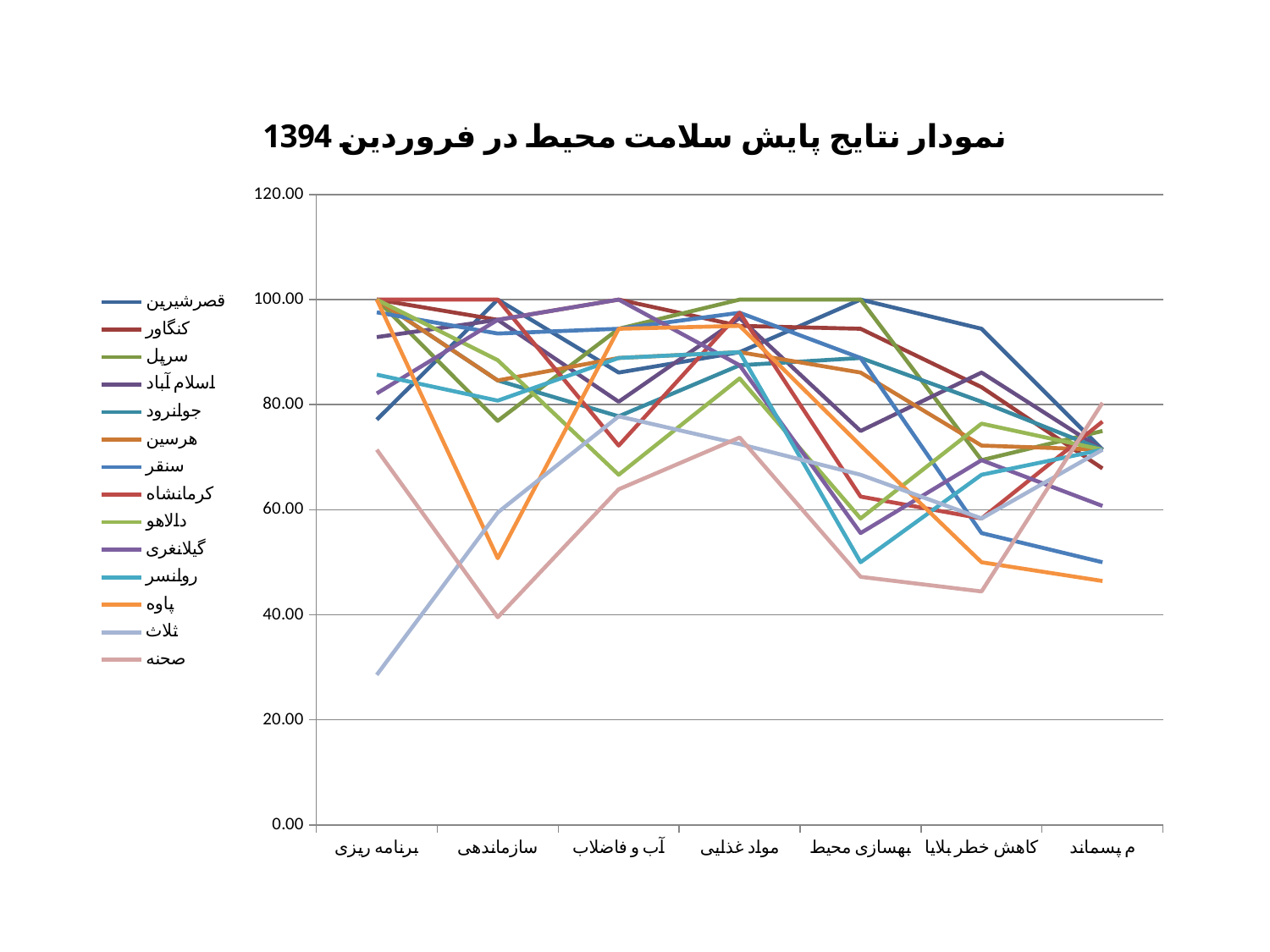
Which series has the lowest value at برنامه ریزی? ثلاث Is the value for ثلاث at برنامه ریزی greater or less than 40? less Is the value for صحنه at کاهش خطر بلایا greater or less than 60? less How many series does the legend list? 14 What kind of chart is shown on the slide? line chart How many categories are shown along the x axis? 7 Which series is listed last in the legend? صحنه At برنامه ریزی, which is larger: the value for ثلاث or the value for صحنه? صحنه Is the value for پاوه at م پسماند greater or less than 60? less What is the title of the chart? نمودار نتایج پایش سلامت محیط در فروردین 1394 Which series has the lowest value at سازماندهی? صحنه